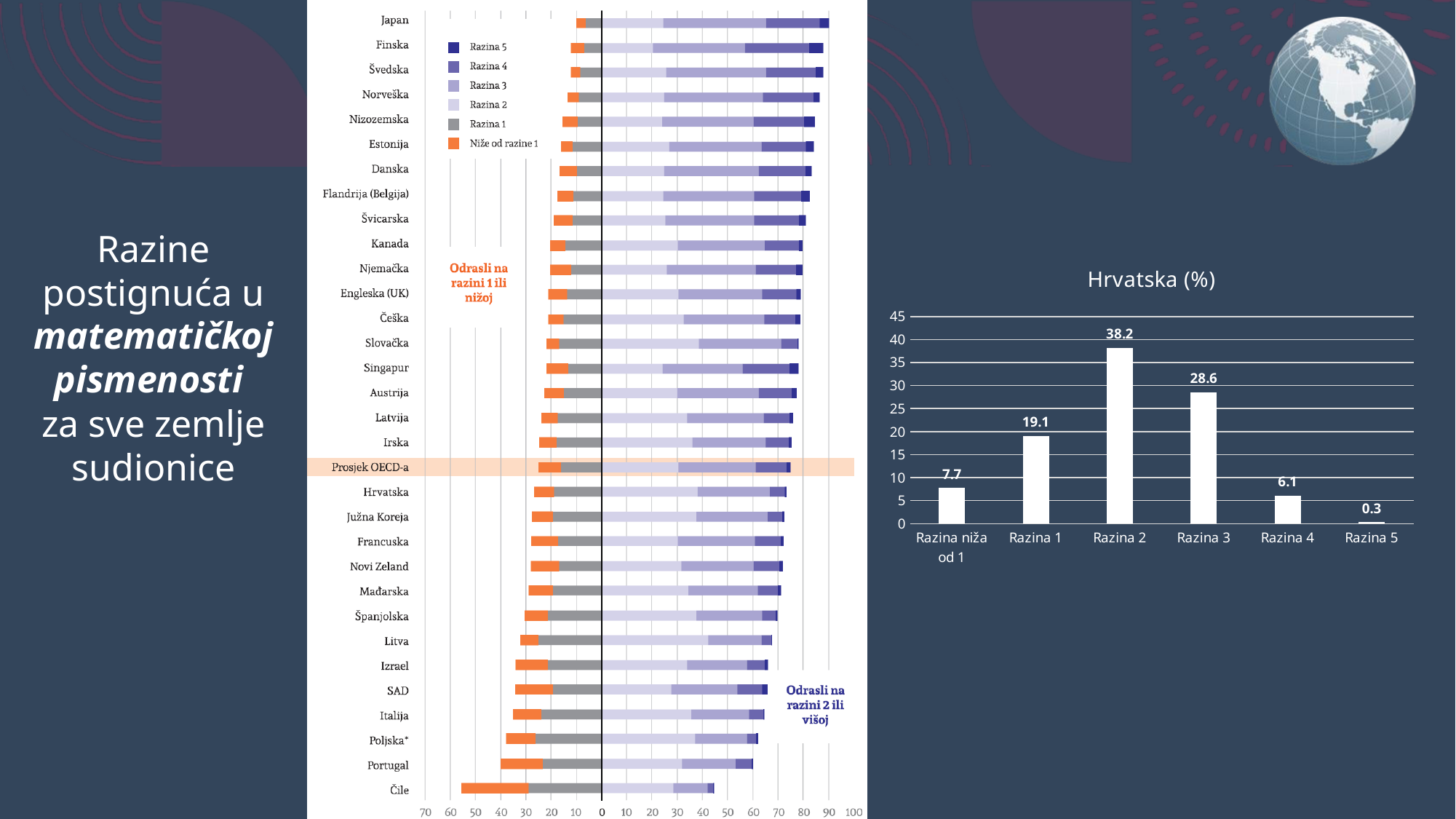
In the Hrvatska (%) chart, what is the value for Razina niža od 1? 7.7 In the Hrvatska (%) chart, what is the difference between Razina 2 and Razina 3? 9.6 In the large stacked chart on the left, is the right-hand (Razina 2 ili višoj) bar for Čile greater or less than 50? less In the Hrvatska (%) chart, how many categories are shown on the x axis? 6 In the Hrvatska (%) chart, which category has the lowest value? Razina 5 What kind of chart is the Hrvatska (%) chart? Bar chart In the Hrvatska (%) chart, what is the value for Razina 4? 6.1 In the Hrvatska (%) chart, which category has the highest value? Razina 2 In the Hrvatska (%) chart, which is larger: Razina 1 or Razina 4? Razina 1 In the large stacked chart on the left, which country is listed at the top? Japan In the large stacked chart on the left, how many series does the legend list? 6 In the Hrvatska (%) chart, what is the value for Razina 2? 38.2